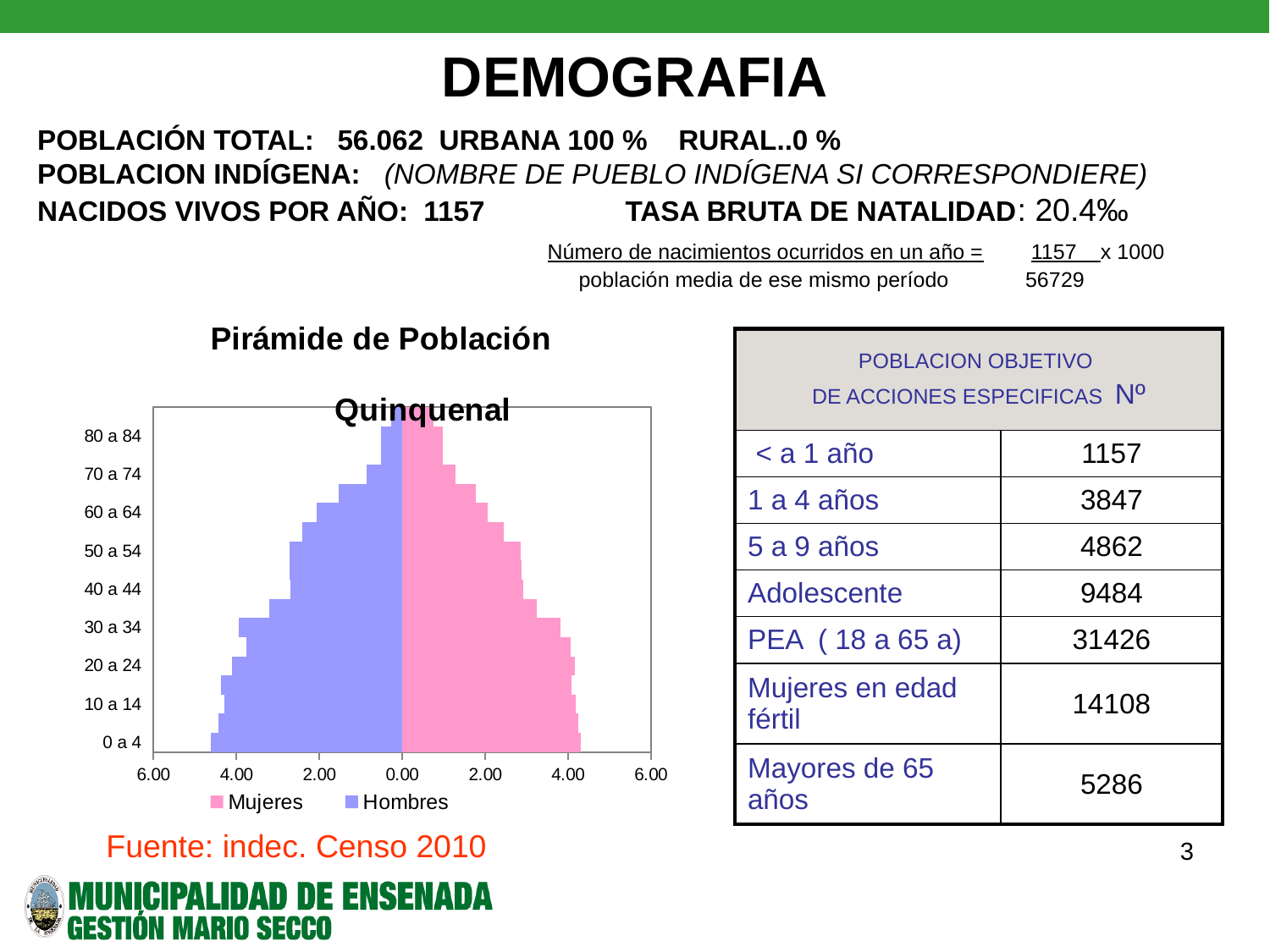
In the population pyramid, is the Hombres value for the 80 a 84 age group greater or less than 2.00? less In the population pyramid, is the Hombres value for the 40 a 44 age group greater or less than 2.00? greater In the population pyramid, is the Hombres value for the 0 a 4 age group greater or less than 4.00? greater How many series does the legend of the population pyramid list? 2 In the population pyramid, do the bars generally get longer or shorter as the age group increases? shorter In the population pyramid, which labelled age group has the longest Hombres bar? 0 a 4 What are the two series named in the legend of the population pyramid? Mujeres and Hombres What type of chart is the 'Pirámide de Población Quinquenal'? bar chart Which colour represents Mujeres in the population pyramid? pink